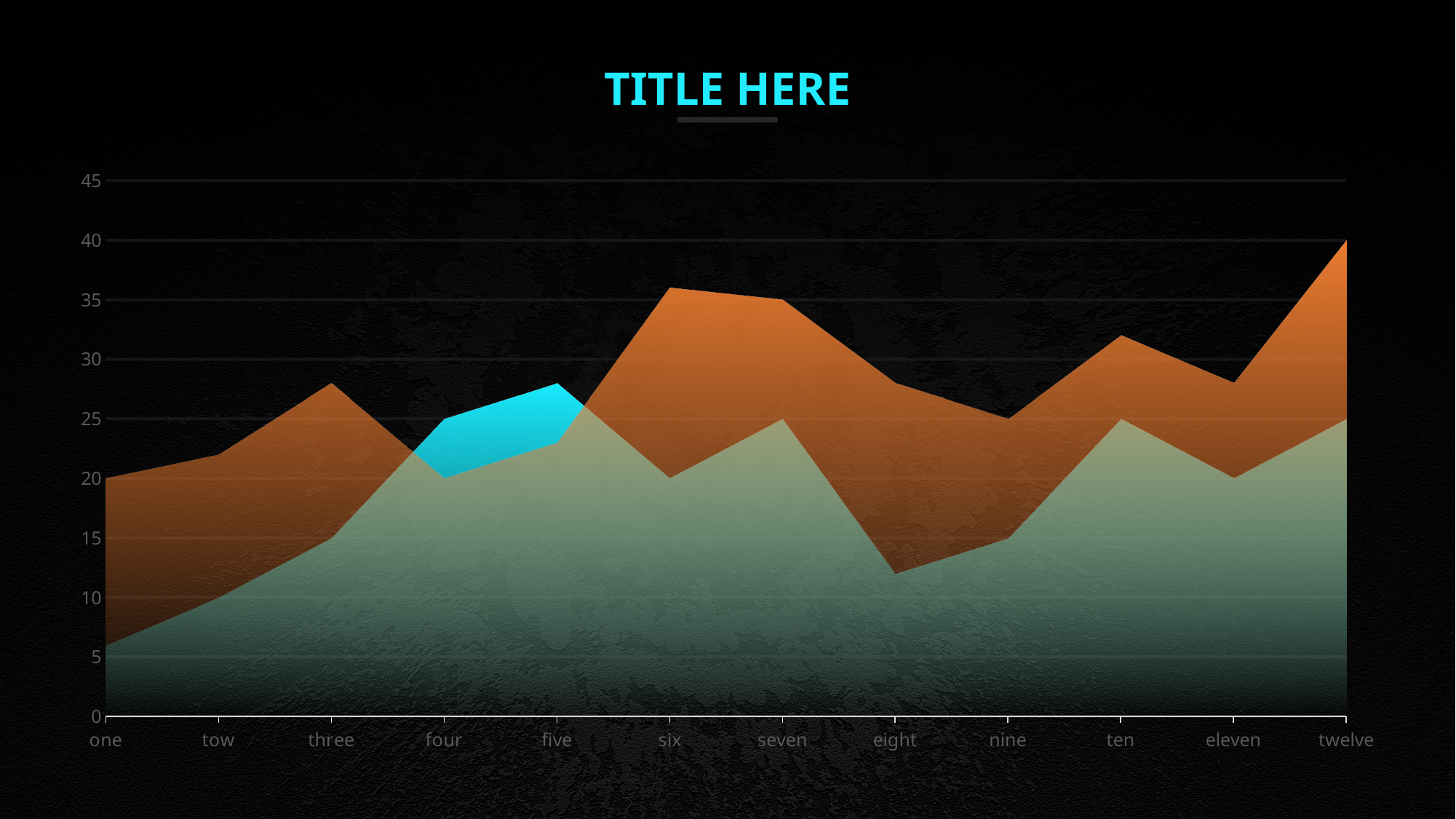
Is the value of the green series at one greater or less than 10? less Is the value of the orange series at ten greater or less than 30? greater Does the orange series rise or fall from six to nine? fall How many data series are plotted on the chart? 2 What kind of chart is shown on the slide? area chart Is the value of the orange series at six greater or less than 30? greater At category four, which series has the higher value, the orange series or the green series? green series Which category has the highest value for the orange series? twelve How many categories are shown on the x axis? 12 Which category has the lowest value for the green series? one What is the title of the chart slide? TITLE HERE